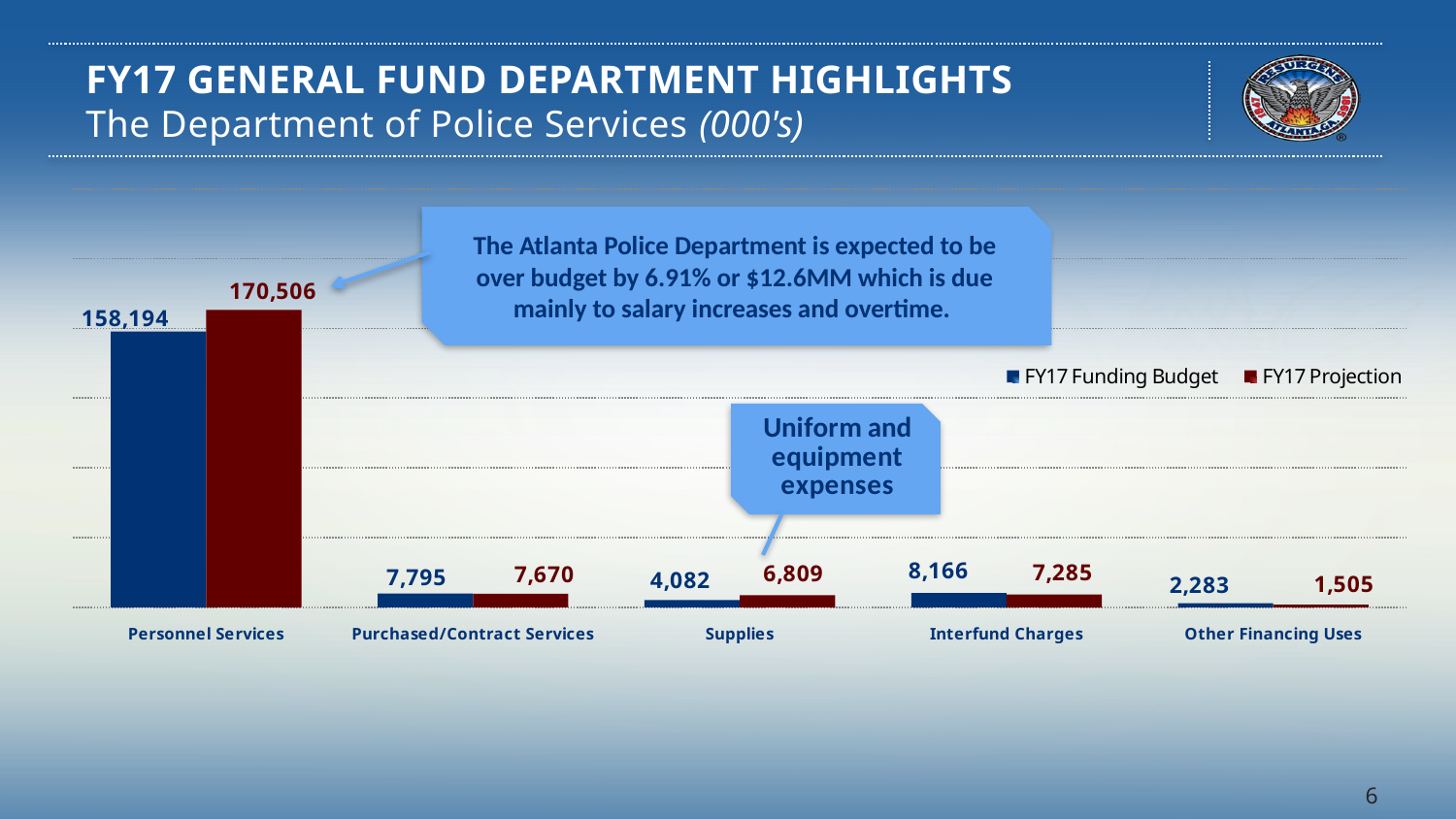
Which category has the lowest FY17 Funding Budget value? Other Financing Uses What is the FY17 Funding Budget value for Personnel Services? 158,194 What is the FY17 Projection value for Other Financing Uses? 1,505 What kind of chart is shown on the slide? Bar chart What is the difference between the FY17 Projection and the FY17 Funding Budget for Personnel Services? 12,312 What is the FY17 Projection value for Supplies? 6,809 What is the FY17 Funding Budget value for Interfund Charges? 8,166 How many series does the chart legend list? 2 What is the difference between the FY17 Projection and the FY17 Funding Budget for Supplies? 2,727 Which category has the highest FY17 Projection value? Personnel Services How many categories are shown on the x axis of the chart? 5 For Interfund Charges, which is larger: the FY17 Funding Budget or the FY17 Projection? FY17 Funding Budget